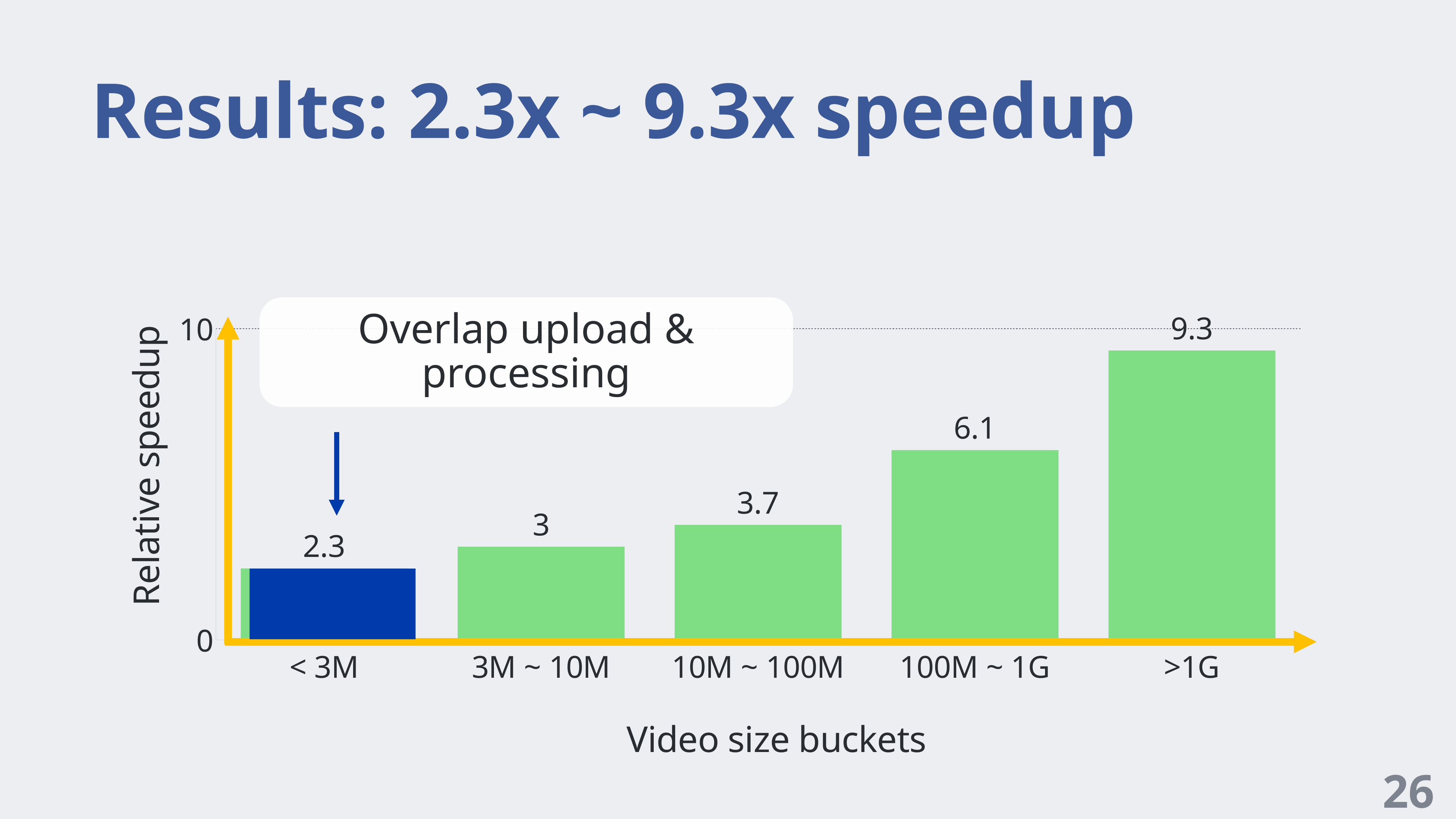
What is the label of the y axis? Relative speedup Which has a larger relative speedup, the 3M ~ 10M bucket or the 100M ~ 1G bucket? 100M ~ 1G Do the relative speedup values rise or fall as video size buckets increase along the x axis? Rise What does the callout box above the chart say? Overlap upload & processing What is the relative speedup for the 10M ~ 100M bucket? 3.7 Which video size bucket has the highest relative speedup? >1G What kind of chart is shown on the slide? Bar chart What is the relative speedup for the >1G bucket? 9.3 What is the relative speedup for the < 3M video size bucket? 2.3 What is the difference in relative speedup between the >1G bucket and the 100M ~ 1G bucket? 3.2 How many video size buckets are shown on the x axis? 5 Which video size bucket has the lowest relative speedup? < 3M